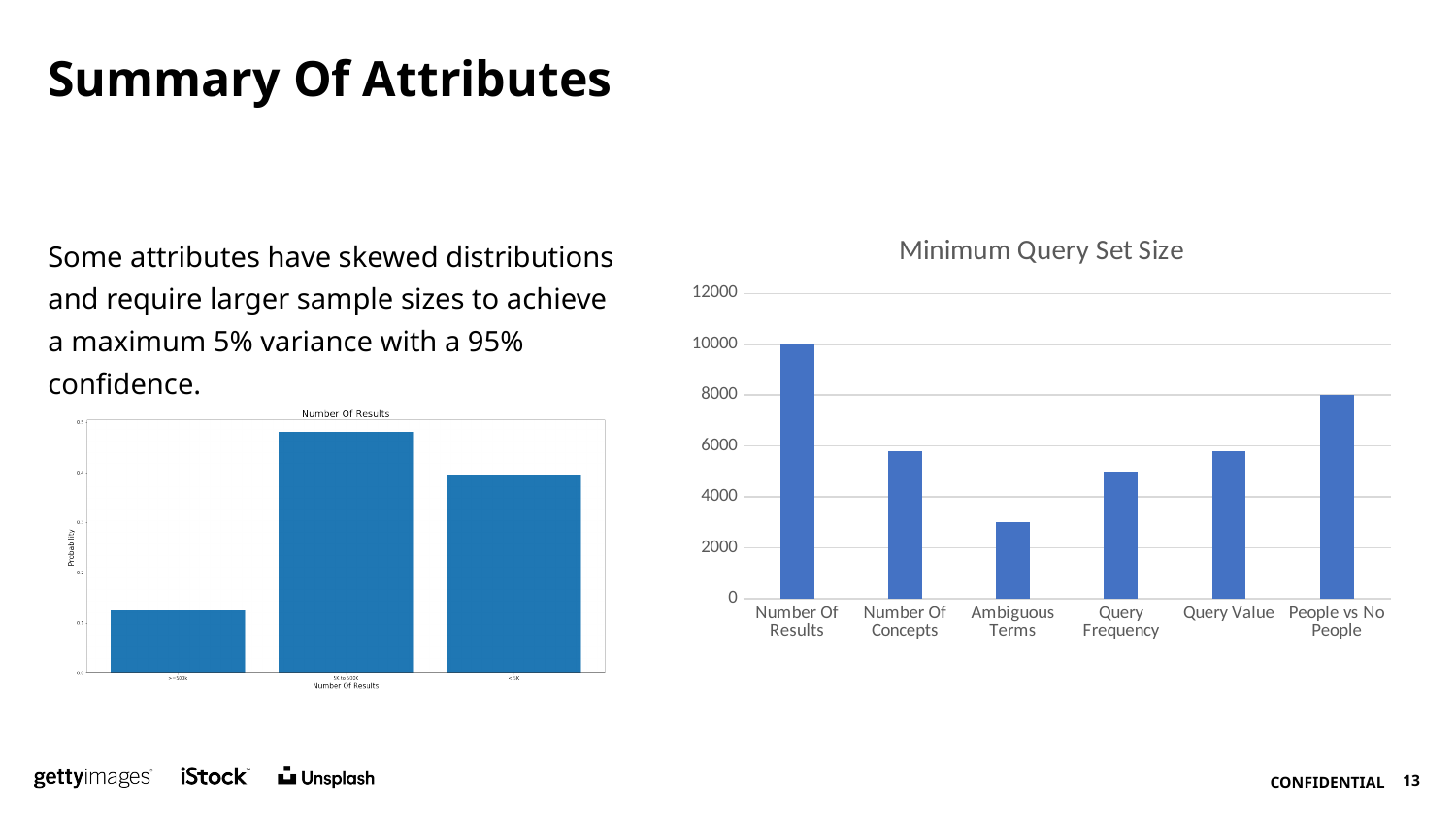
In the 'Minimum Query Set Size' chart, is the value for Query Frequency greater or less than 6000? less What kind of chart is the 'Minimum Query Set Size' chart? bar chart In the 'Minimum Query Set Size' chart, what is the value for Number Of Results? 10000 In the 'Minimum Query Set Size' chart, which attribute has the largest minimum query set size? Number Of Results In the 'Minimum Query Set Size' chart, which is larger: the value for People vs No People or the value for Query Frequency? People vs No People In the 'Minimum Query Set Size' chart, how many attributes are plotted? 6 In the 'Minimum Query Set Size' chart, is the value for Number Of Concepts greater or less than 4000? greater In the 'Minimum Query Set Size' chart, what is the difference between the values for Number Of Results and People vs No People? 2000 What is the title of the chart on the right side of the slide? Minimum Query Set Size In the 'Minimum Query Set Size' chart, which attribute has the smallest minimum query set size? Ambiguous Terms In the 'Minimum Query Set Size' chart, what is the value for People vs No People? 8000 In the 'Minimum Query Set Size' chart, is the value for Ambiguous Terms greater or less than 4000? less